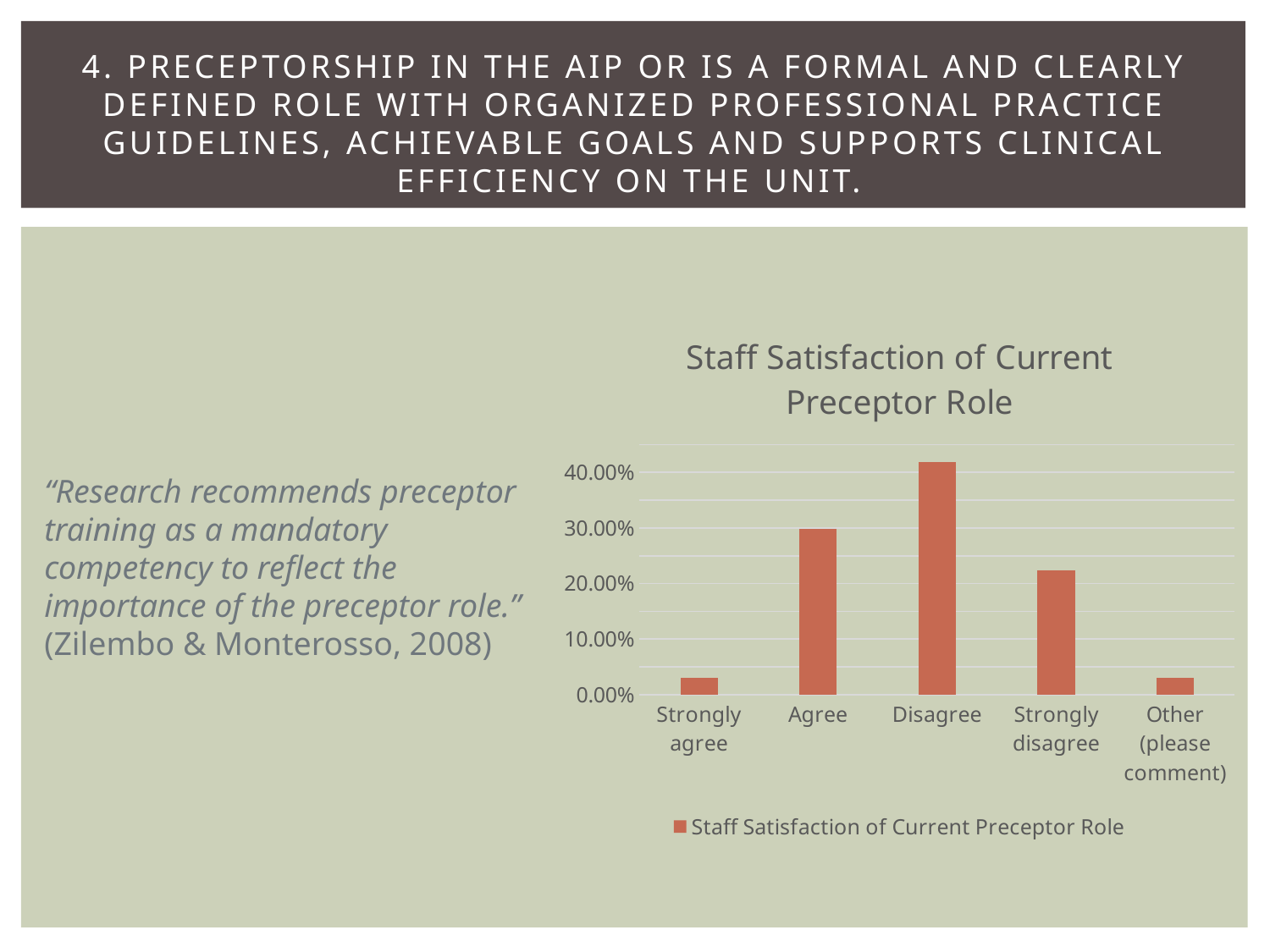
What is the title of the chart? Staff Satisfaction of Current Preceptor Role Which category has the highest value in the chart? Disagree What kind of chart is shown on the slide? bar chart Is the value for Disagree greater or less than 30.00%? greater Which is larger, the value for Agree or the value for Strongly disagree? Agree Is the value for Strongly agree greater or less than 10.00%? less Is the value for Other (please comment) greater or less than 10.00%? less How many categories are shown on the x axis of the chart? 5 Which is larger, the value for Disagree or the value for Agree? Disagree How many series does the chart's legend list? 1